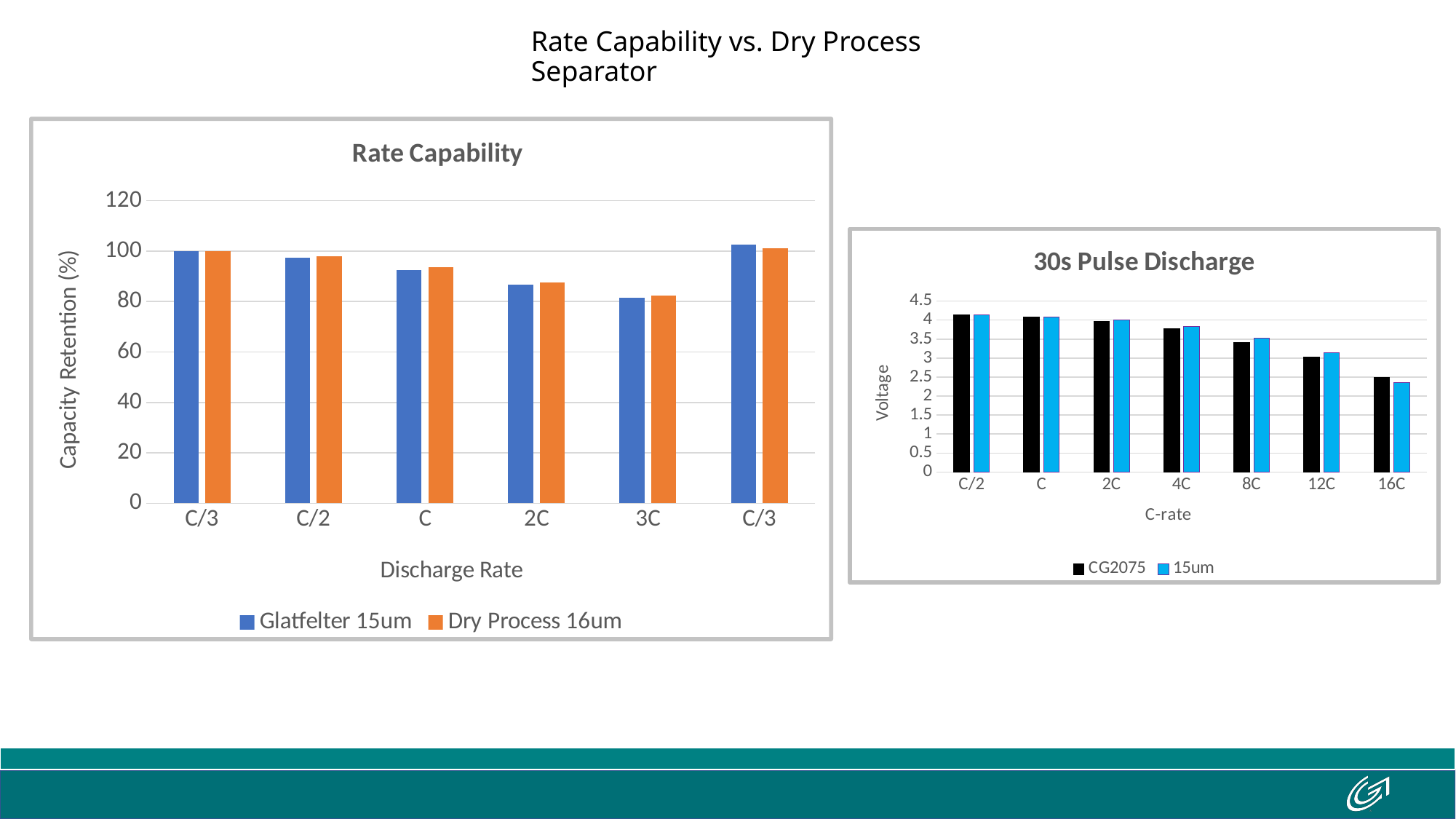
In the '30s Pulse Discharge' chart, is the CG2075 voltage at 16C greater or less than 3? less In the '30s Pulse Discharge' chart, at 16C, which series has the higher voltage, CG2075 or 15um? CG2075 In the 'Rate Capability' chart, is the Dry Process 16um value at C greater or less than 80? greater In the 'Rate Capability' chart, which discharge rate has the lowest capacity retention? 3C How many series does the legend of the '30s Pulse Discharge' chart list? 2 How many series does the legend of the 'Rate Capability' chart list? 2 How many C-rate categories are shown on the x axis of the '30s Pulse Discharge' chart? 7 In the 'Rate Capability' chart, is the Glatfelter 15um value at 2C greater or less than 100? less In the '30s Pulse Discharge' chart, do the voltage values rise or fall as the C-rate increases along the x axis? fall In the 'Rate Capability' chart, what is the label of the y axis? Capacity Retention (%) What type of chart is the 'Rate Capability' chart? bar chart How many discharge rate categories are shown on the x axis of the 'Rate Capability' chart? 6